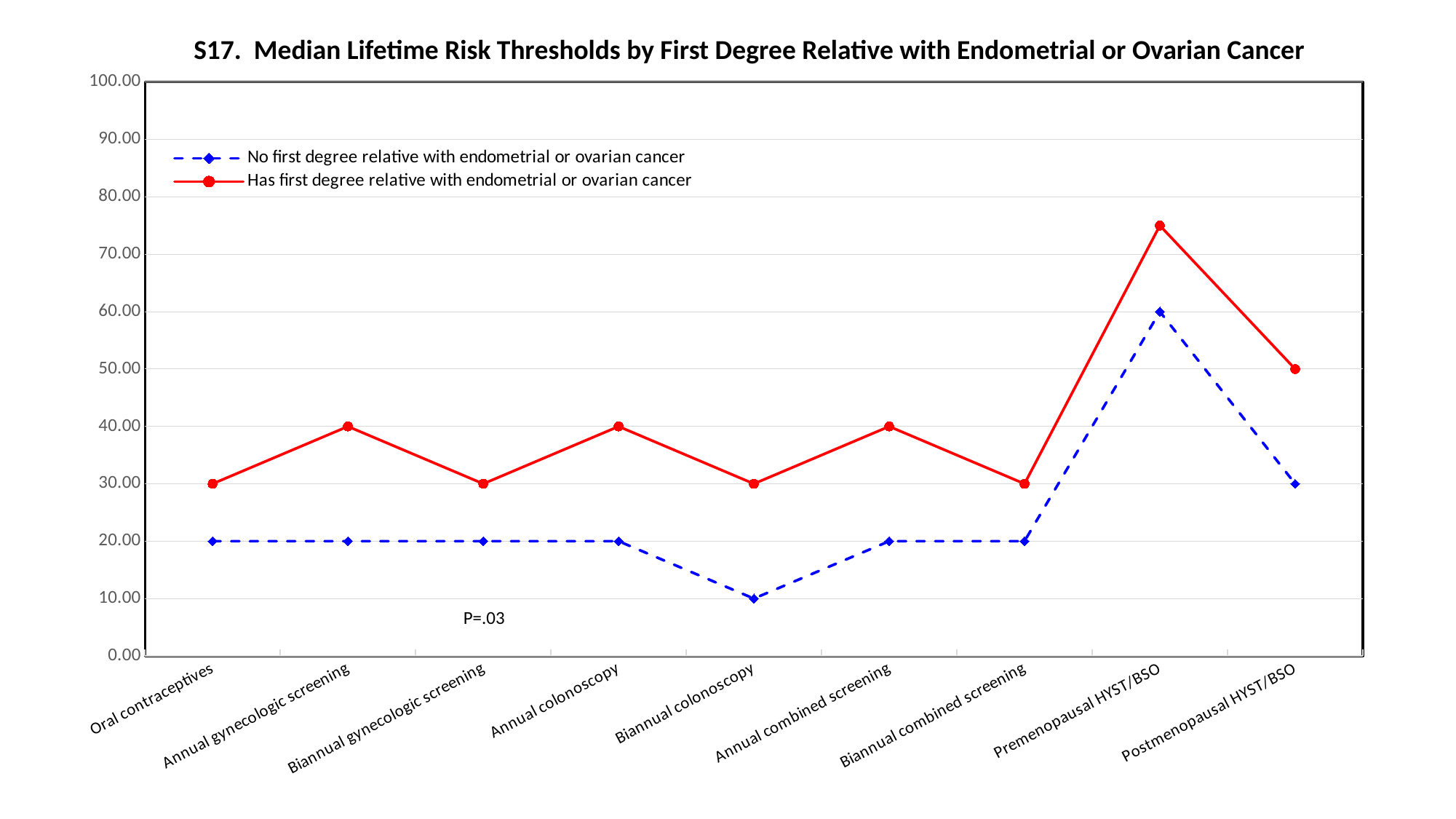
How many categories are shown along the x axis? 9 For Annual gynecologic screening, what is the difference between the 'Has first degree relative' value and the 'No first degree relative' value? 20.00 How many series does the legend list? 2 For Postmenopausal HYST/BSO, which series has the larger value? Has first degree relative with endometrial or ovarian cancer What kind of chart is shown on the slide? line chart What P value is annotated on the chart? P=.03 Which category has the highest value in the 'Has first degree relative with endometrial or ovarian cancer' series? Premenopausal HYST/BSO Which category has the lowest value in the 'No first degree relative with endometrial or ovarian cancer' series? Biannual colonoscopy What is the value for Oral contraceptives in the 'Has first degree relative with endometrial or ovarian cancer' series? 30.00 What is the value for Biannual colonoscopy in the 'No first degree relative with endometrial or ovarian cancer' series? 10.00 Is the value for Premenopausal HYST/BSO in the 'Has first degree relative with endometrial or ovarian cancer' series greater or less than 70.00? greater What is the value for Premenopausal HYST/BSO in the 'No first degree relative with endometrial or ovarian cancer' series? 60.00